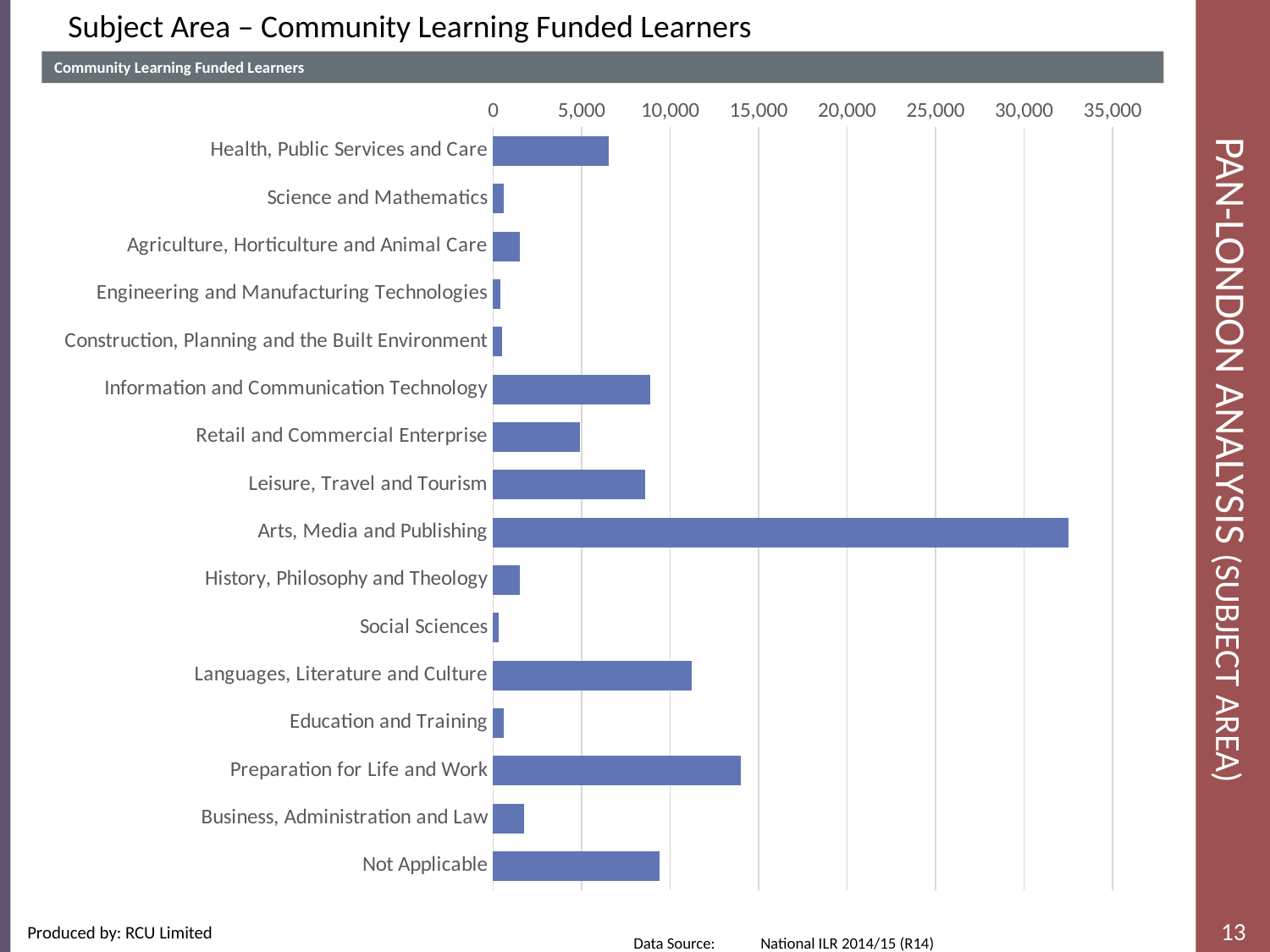
Which has more learners: Health, Public Services and Care or Retail and Commercial Enterprise? Health, Public Services and Care What is the title shown in the header bar above the chart? Community Learning Funded Learners Is the value for Preparation for Life and Work greater or less than 15,000? less Is the value for Health, Public Services and Care greater or less than 5,000? greater Which has more learners: Preparation for Life and Work or Languages, Literature and Culture? Preparation for Life and Work Which subject area has the highest number of Community Learning Funded Learners? Arts, Media and Publishing Is the value for Information and Communication Technology greater or less than 10,000? less What kind of chart is shown on the slide? bar chart What is the highest value labelled on the horizontal axis of the chart? 35,000 How many subject area categories are plotted in the chart? 16